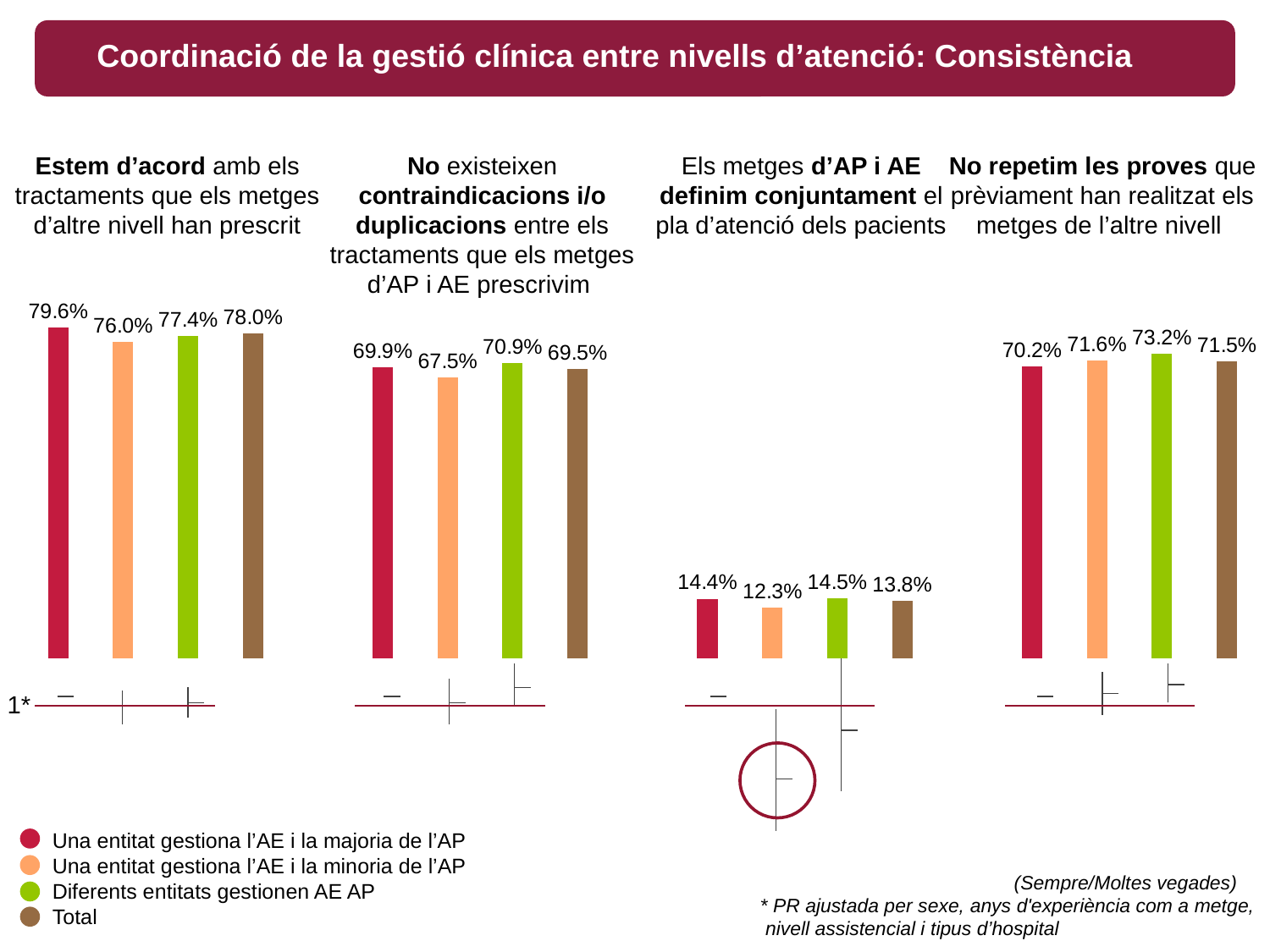
In the leftmost chart ('Estem d'acord amb els tractaments...'), what is the value for 'Total'? 78.0% In the leftmost chart ('Estem d'acord amb els tractaments que els metges d'altre nivell han prescrit'), what is the value for 'Una entitat gestiona l'AE i la majoria de l'AP'? 79.6% In the third chart from the left ('Els metges d'AP i AE definim conjuntament...'), what is the value for 'Total'? 13.8% In the second chart from the left ('No existeixen contraindicacions i/o duplicacions...'), what is the difference between 'Diferents entitats gestionen AE AP' and 'Una entitat gestiona l'AE i la minoria de l'AP'? 3.4% In the rightmost chart ('No repetim les proves que prèviament han realitzat els metges de l'altre nivell'), what is the value for 'Diferents entitats gestionen AE AP'? 73.2% In the second chart from the left ('No existeixen contraindicacions i/o duplicacions...'), which group has the lowest value? Una entitat gestiona l'AE i la minoria de l'AP In the rightmost chart ('No repetim les proves...'), which is larger: the value for 'Una entitat gestiona l'AE i la majoria de l'AP' or for 'Diferents entitats gestionen AE AP'? Diferents entitats gestionen AE AP In the second chart from the left ('No existeixen contraindicacions i/o duplicacions...'), what is the value for 'Diferents entitats gestionen AE AP'? 70.9% How many bars does each of the four charts on the slide have? 4 How many entries does the legend at the bottom left of the slide list? 4 In the third chart from the left ('Els metges d'AP i AE definim conjuntament el pla d'atenció dels pacients'), what is the value for 'Una entitat gestiona l'AE i la minoria de l'AP'? 12.3% In the leftmost chart ('Estem d'acord amb els tractaments...'), which group has the highest value? Una entitat gestiona l'AE i la majoria de l'AP